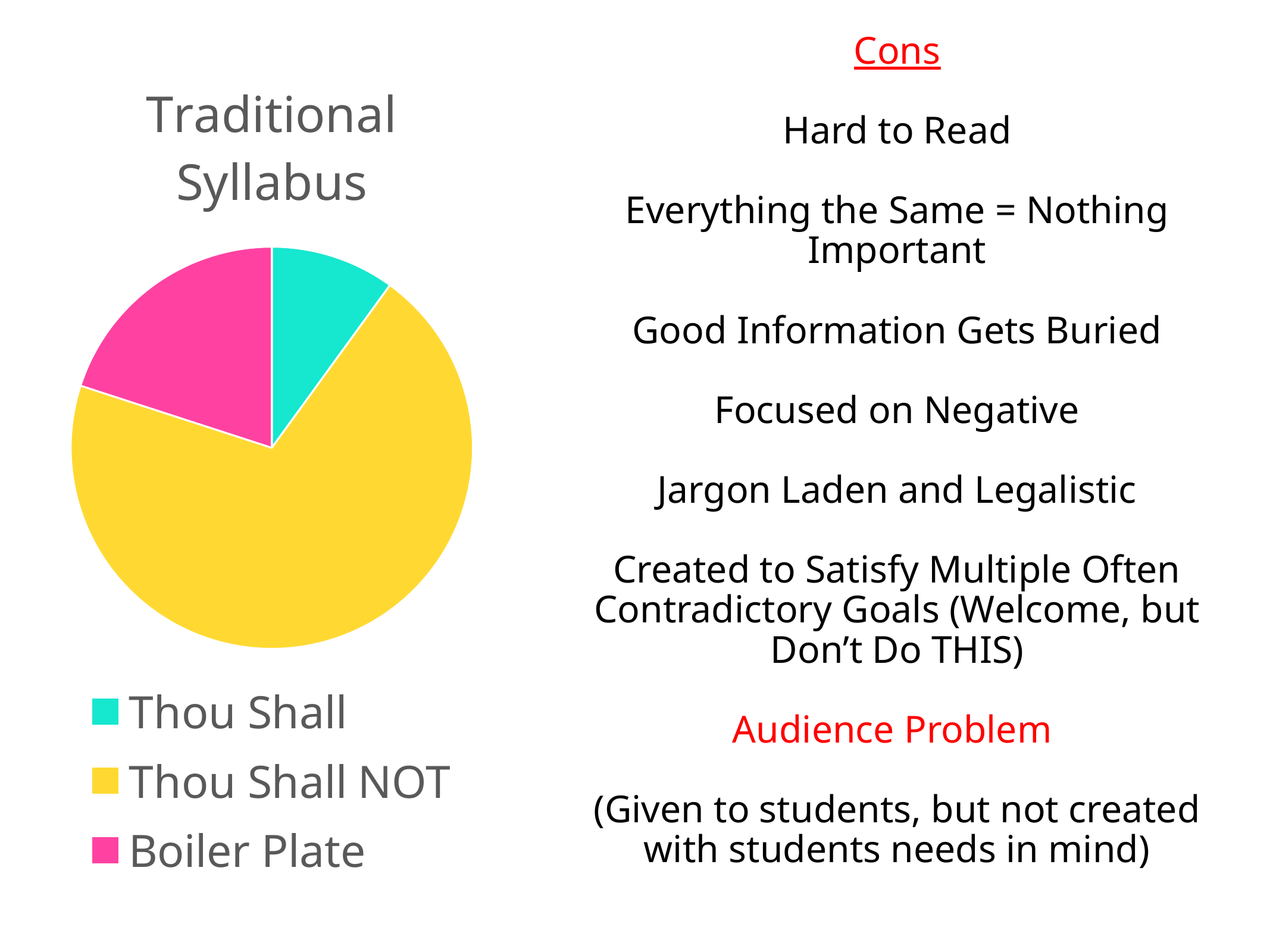
Which slice is larger, Boiler Plate or Thou Shall? Boiler Plate Which colour represents Thou Shall NOT in the pie chart? yellow What is the title of the chart? Traditional Syllabus Which category has the smallest slice of the pie? Thou Shall How many entries does the legend list? 3 Which slice is larger, Thou Shall NOT or Boiler Plate? Thou Shall NOT How many slices does the pie chart have? 3 Which category has the largest slice of the pie? Thou Shall NOT What kind of chart is shown on the slide? pie chart